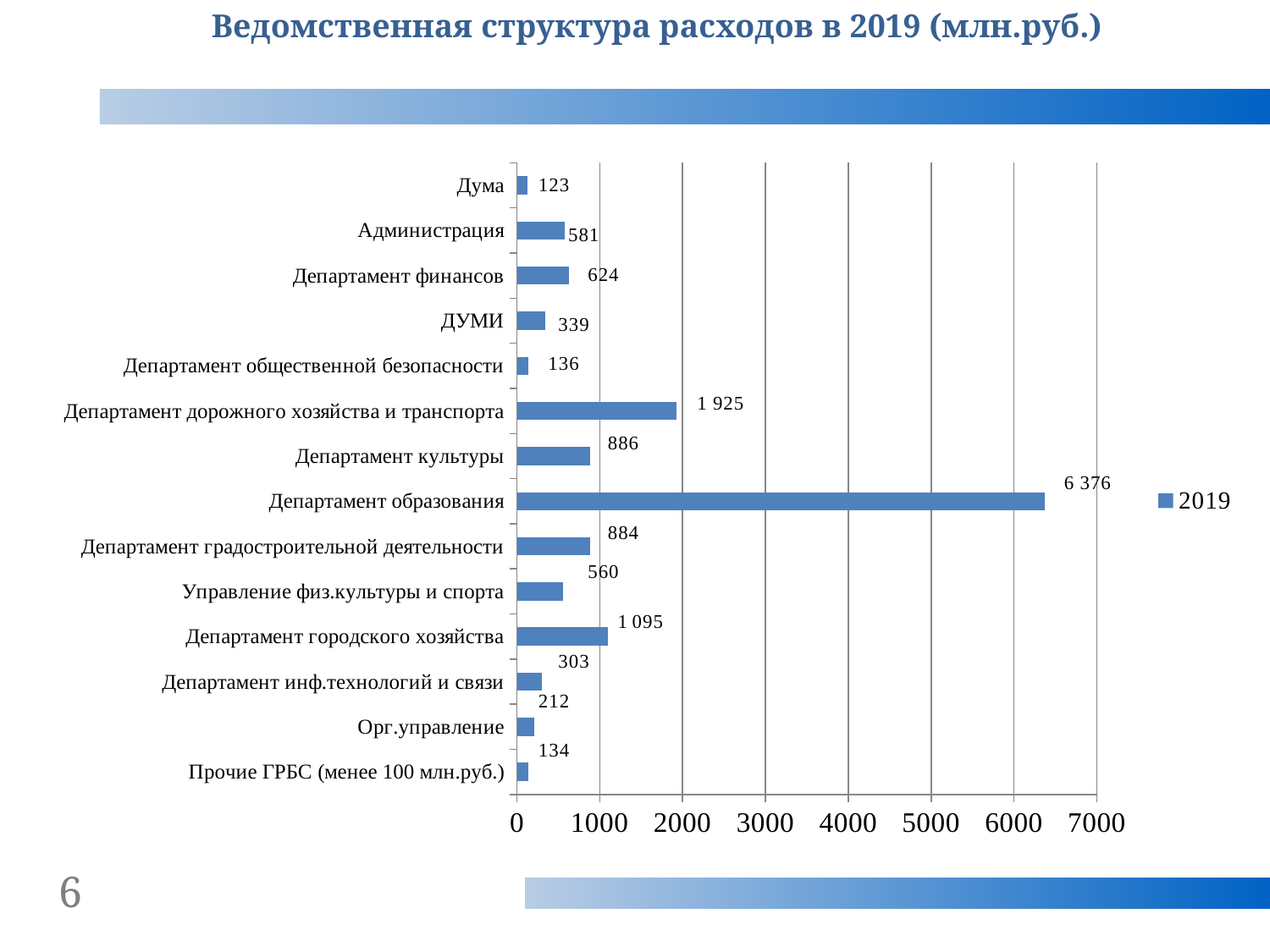
What is the difference between the values for Департамент финансов and Администрация? 43 What is the value for Департамент дорожного хозяйства и транспорта? 1 925 Which is larger, the value for Департамент городского хозяйства or the value for Департамент культуры? Департамент городского хозяйства What is the value for Департамент образования? 6 376 What kind of chart is shown on the slide? Bar chart Which category has the highest value? Департамент образования How many series does the legend list? 1 How many categories are shown in the chart? 14 What is the value for ДУМИ? 339 What is the difference between the values for Департамент образования and Департамент дорожного хозяйства и транспорта? 4 451 Which category has the lowest value? Дума What is the value for Прочие ГРБС (менее 100 млн.руб.)? 134